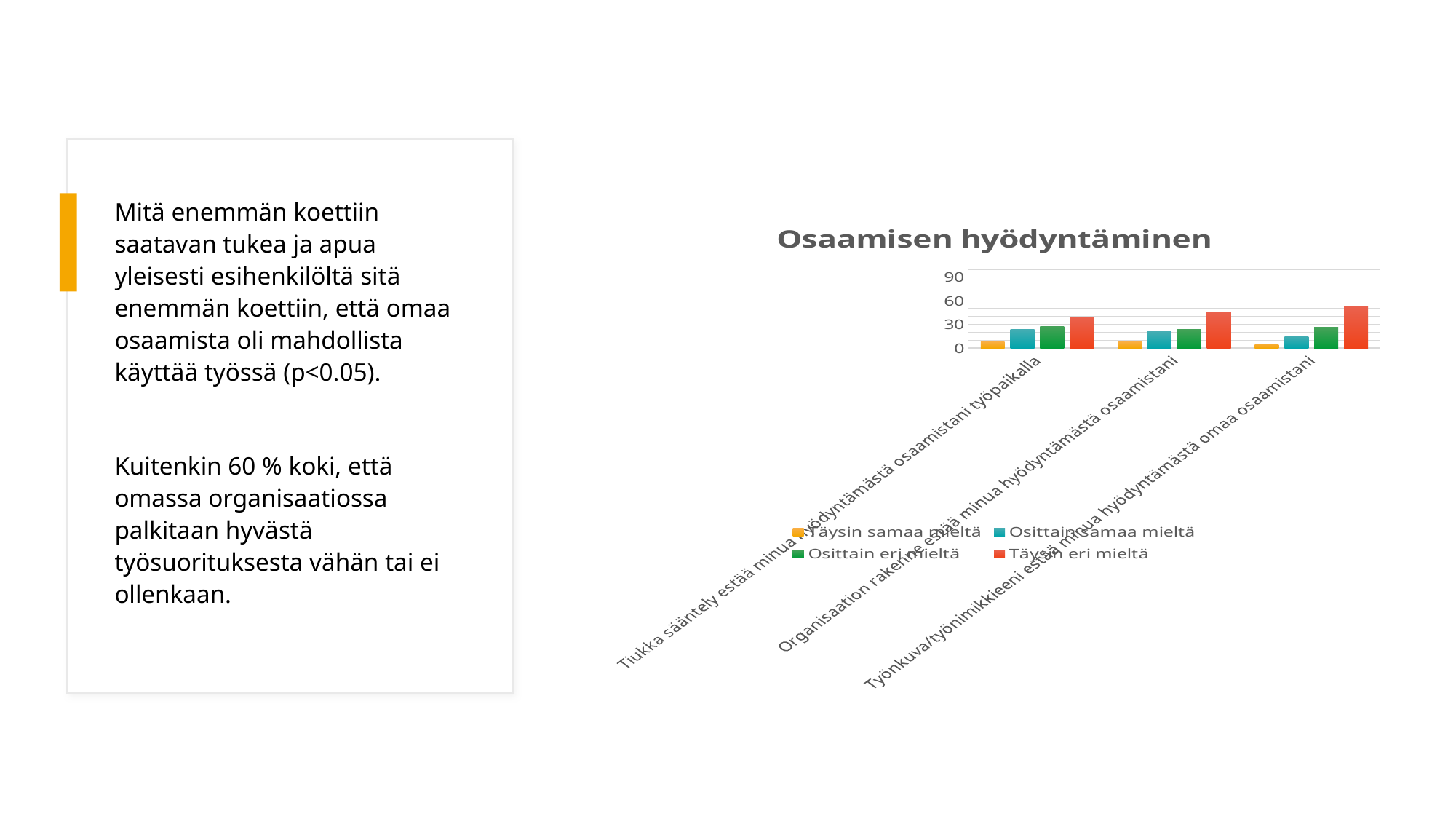
For 'Organisaation rakenne estää minua hyödyntämästä osaamistani', which is larger: 'Täysin eri mieltä' or 'Täysin samaa mieltä'? Täysin eri mieltä How many series does the chart's legend list? 4 What kind of chart is shown on the slide? bar chart How many categories are shown on the x axis of the chart? 3 Across the three categories, which category has the highest 'Täysin eri mieltä' value? Työnkuva/työnimikkeeni estää minua hyödyntämästä omaa osaamistani What is the title of the chart? Osaamisen hyödyntäminen Is the value of 'Täysin eri mieltä' for 'Organisaation rakenne estää minua hyödyntämästä osaamistani' greater or less than 60? less Is the value of 'Täysin samaa mieltä' for 'Tiukka sääntely estää minua hyödyntämästä osaamistani työpaikalla' greater or less than 30? less Is the value of 'Täysin eri mieltä' for 'Työnkuva/työnimikkeeni estää minua hyödyntämästä omaa osaamistani' greater or less than 30? greater Which series has the highest value for the category 'Työnkuva/työnimikkeeni estää minua hyödyntämästä omaa osaamistani'? Täysin eri mieltä What colour represents the 'Täysin eri mieltä' series in the chart? red Which series has the lowest value for the category 'Tiukka sääntely estää minua hyödyntämästä osaamistani työpaikalla'? Täysin samaa mieltä